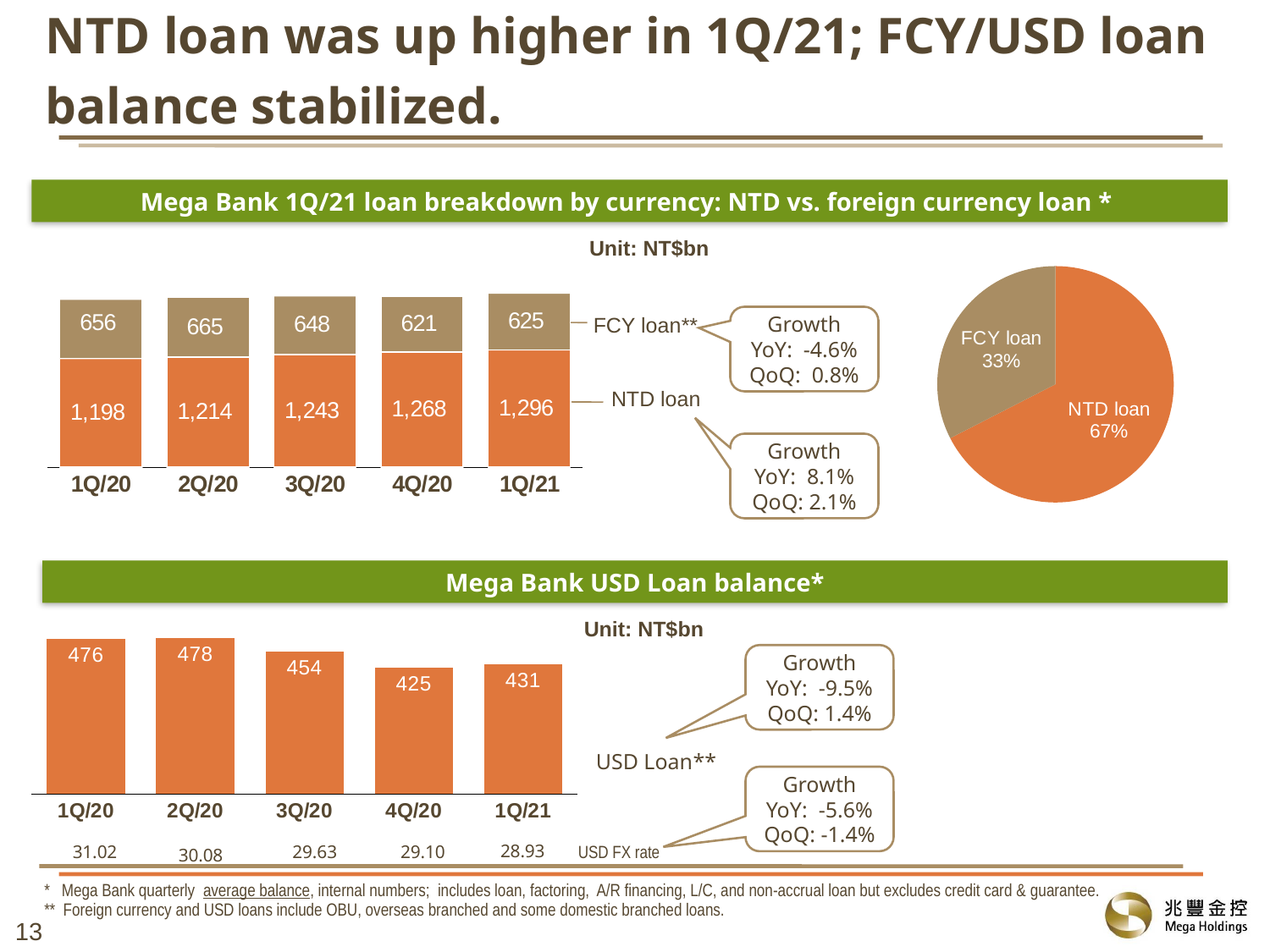
In the 'Mega Bank USD Loan balance' chart, what is the difference between the 1Q/20 and 1Q/21 values? 45 In the 'Mega Bank 1Q/21 loan breakdown by currency' stacked bar chart, what is the FCY loan value for 2Q/20? 665 What type of chart is the 'Mega Bank USD Loan balance' chart? bar chart In the 'Mega Bank 1Q/21 loan breakdown by currency' stacked bar chart, what is the total loan balance (NTD plus FCY) for 1Q/21? 1,921 In the pie chart on the right of the slide, what share of loans is FCY loan? 33% In the 'Mega Bank 1Q/21 loan breakdown by currency' stacked bar chart, do NTD loan values rise or fall from 1Q/20 to 1Q/21? rise In the 'Mega Bank USD Loan balance' chart, what is the USD loan value for 3Q/20? 454 How many series does the 'Mega Bank 1Q/21 loan breakdown by currency' stacked bar chart show? 2 In the 'Mega Bank 1Q/21 loan breakdown by currency' stacked bar chart, how much did the NTD loan increase from 1Q/20 to 1Q/21? 98 In the 'Mega Bank USD Loan balance' chart, which quarter has the highest USD loan balance? 2Q/20 In the 'Mega Bank 1Q/21 loan breakdown by currency' stacked bar chart, what is the NTD loan value for 1Q/21? 1,296 In the 'Mega Bank 1Q/21 loan breakdown by currency' stacked bar chart, which quarter has the lowest FCY loan value? 4Q/20